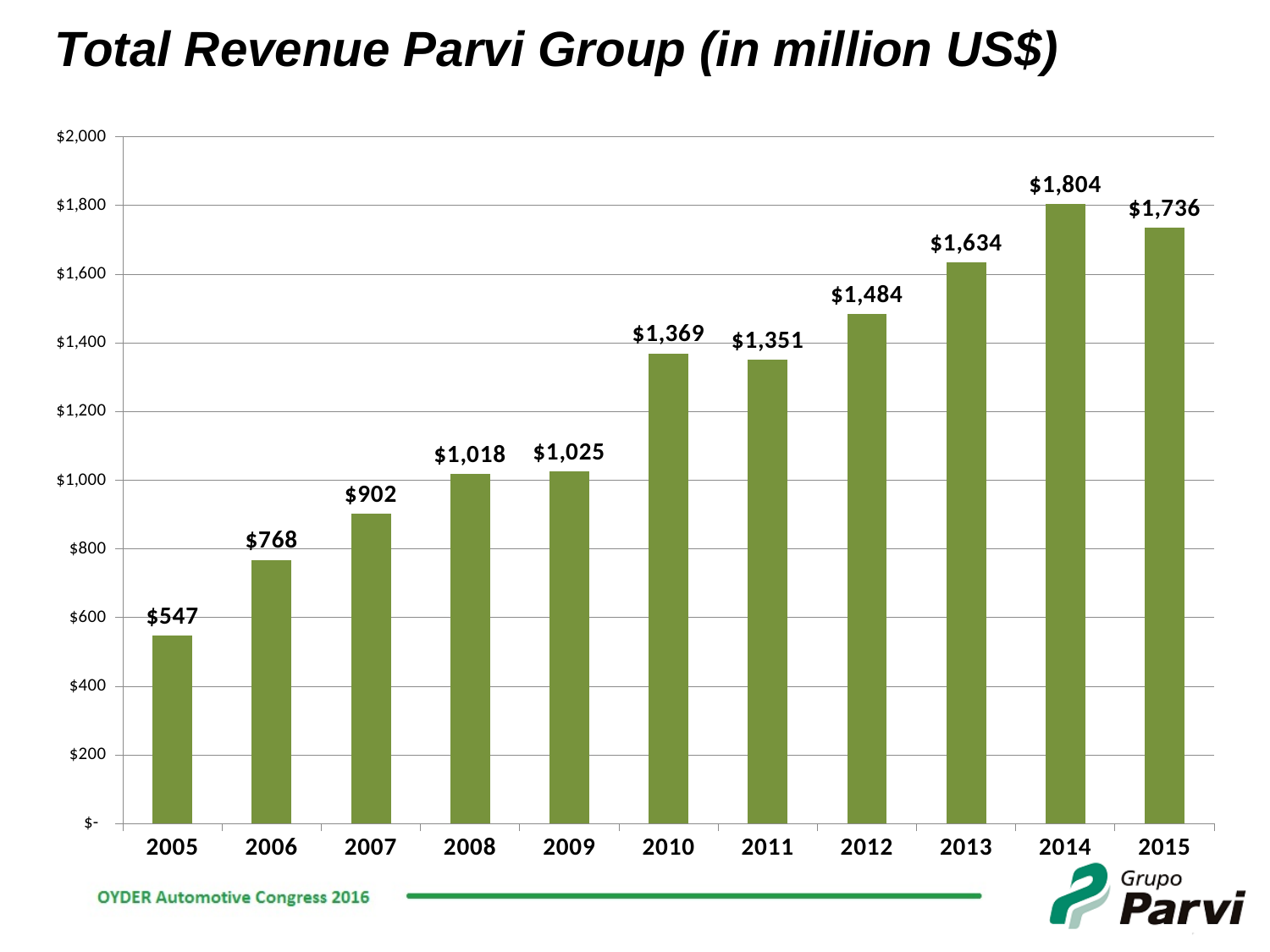
What is the title of the chart? Total Revenue Parvi Group (in million US$) How many years are shown on the chart? 11 What is the difference in total revenue between 2006 and 2005? $221 Which year had the highest total revenue? 2014 What was the total revenue of Parvi Group in 2012? $1,484 What kind of chart is shown on the slide? bar chart Which year had higher total revenue, 2010 or 2011? 2010 What was the total revenue of Parvi Group in 2015? $1,736 What is the difference in total revenue between 2014 and 2015? $68 Is the total revenue for 2013 greater or less than $1,600? greater Which year had the lowest total revenue? 2005 What was the total revenue of Parvi Group in 2005? $547